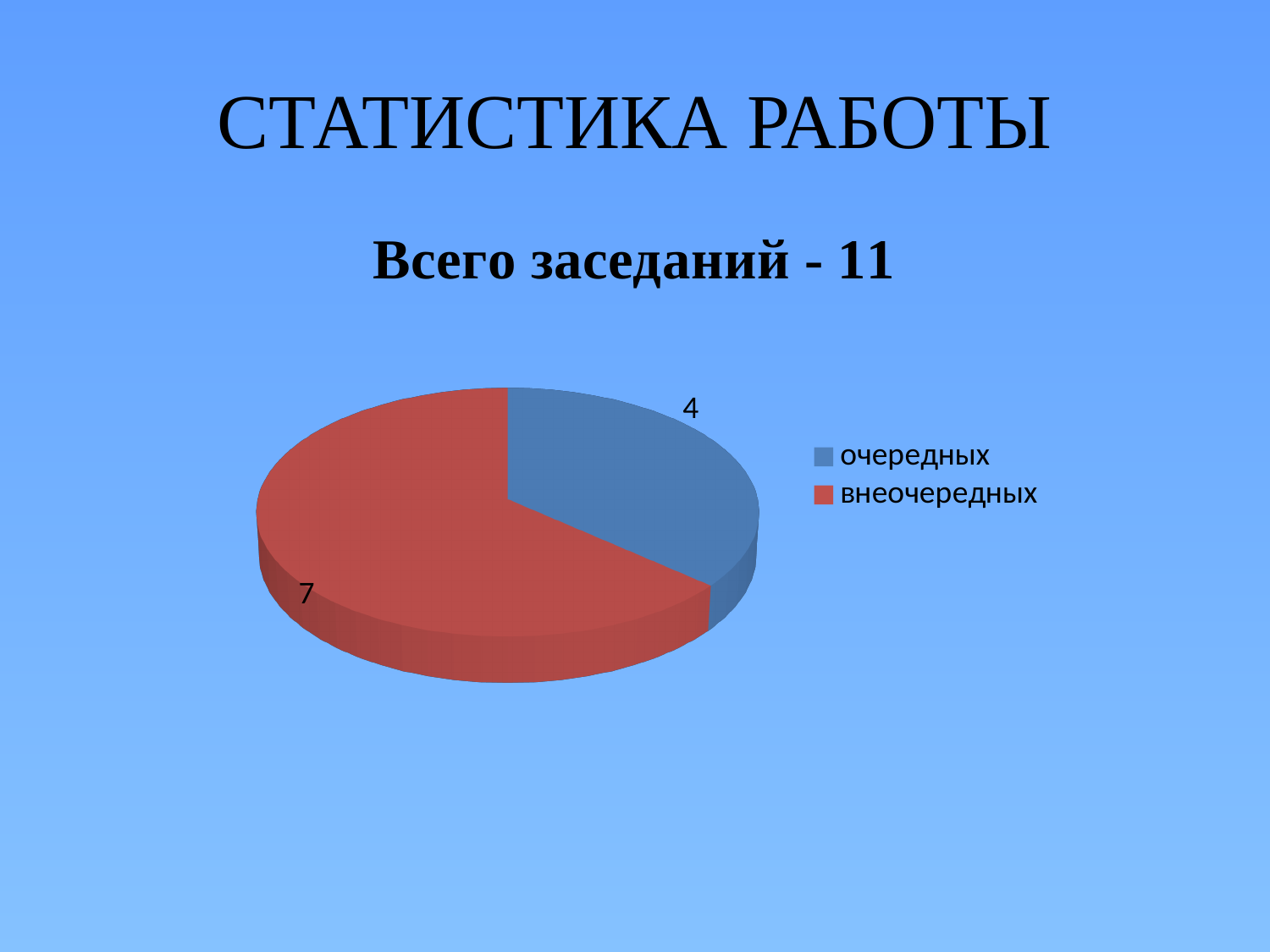
Which category has the largest slice? внеочередных What is the total of all slices in the pie chart? 11 What is the value for внеочередных? 7 What is the difference between the values for внеочередных and очередных? 3 Which is larger, очередных or внеочередных? внеочередных Which category has the smallest slice? очередных What colour is the slice for внеочередных? red What is the subtitle shown above the chart? Всего заседаний - 11 What is the value for очередных? 4 How many slices does the pie chart have? 2 What kind of chart is shown on the slide? pie chart How many entries does the legend list? 2